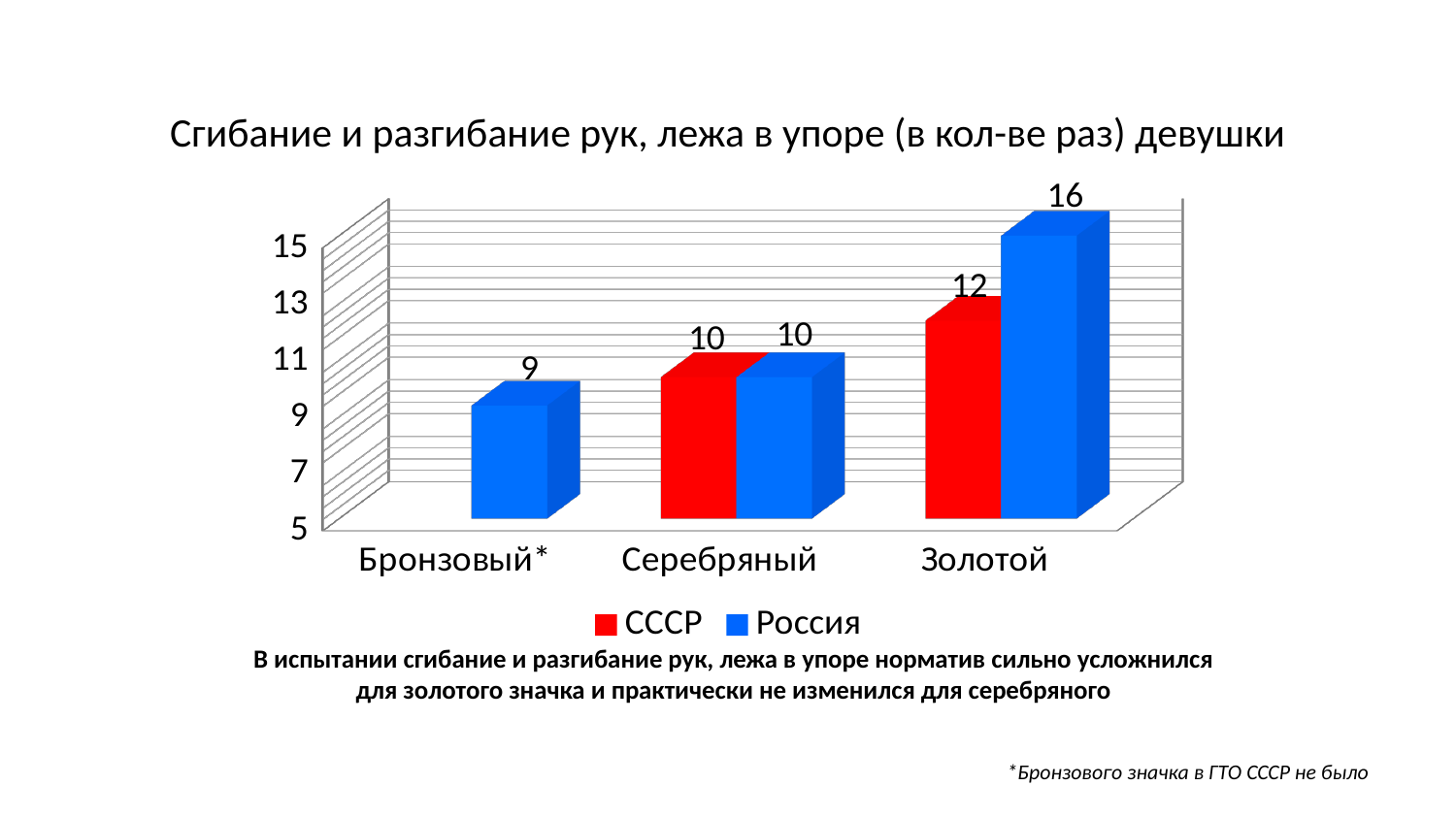
How many categories are shown on the x axis? 3 What is the value for СССР in the Золотой category? 12 What kind of chart is shown on the slide? Bar chart What is the value for Россия in the Золотой category? 16 Which colour represents the СССР series? Red What is the value for СССР in the Серебряный category? 10 Which is larger in the Золотой category: the value for СССР or for Россия? Россия Which category has the highest value for Россия? Золотой How many series does the legend list? 2 Which category has the lowest value for Россия? Бронзовый What is the value for Россия in the Бронзовый category? 9 What is the difference between the Россия and СССР values in the Золотой category? 4